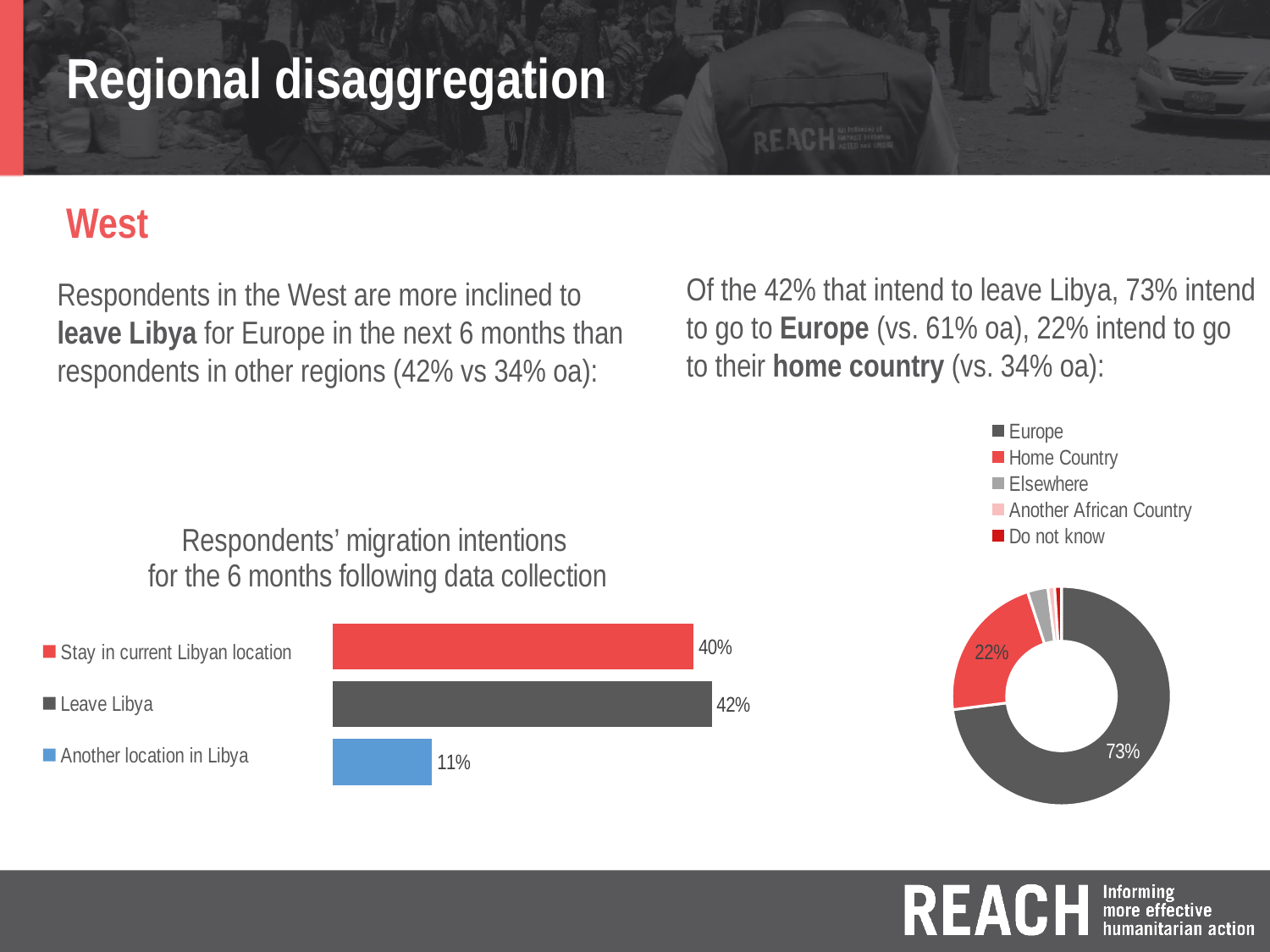
In the bar chart titled "Respondents' migration intentions for the 6 months following data collection", which category has the lowest value? Another location in Libya In the bar chart titled "Respondents' migration intentions for the 6 months following data collection", what is the value for Stay in current Libyan location? 40% In the bar chart titled "Respondents' migration intentions for the 6 months following data collection", what is the value for Another location in Libya? 11% In the bar chart titled "Respondents' migration intentions for the 6 months following data collection", what is the value for Leave Libya? 42% In the doughnut chart on the right of the slide, what share is labelled for Home Country? 22% In the doughnut chart on the right of the slide, how many entries does the legend list? 5 In the bar chart titled "Respondents' migration intentions for the 6 months following data collection", which category has the highest value? Leave Libya In the bar chart titled "Respondents' migration intentions for the 6 months following data collection", how many categories are shown? 3 What kind of chart is the chart titled "Respondents' migration intentions for the 6 months following data collection"? Bar chart In the doughnut chart on the right of the slide, what share is labelled for Europe? 73% In the bar chart titled "Respondents' migration intentions for the 6 months following data collection", what is the difference between the values for Leave Libya and Another location in Libya? 31% In the doughnut chart on the right of the slide, which is larger, the share for Europe or the share for Home Country? Europe